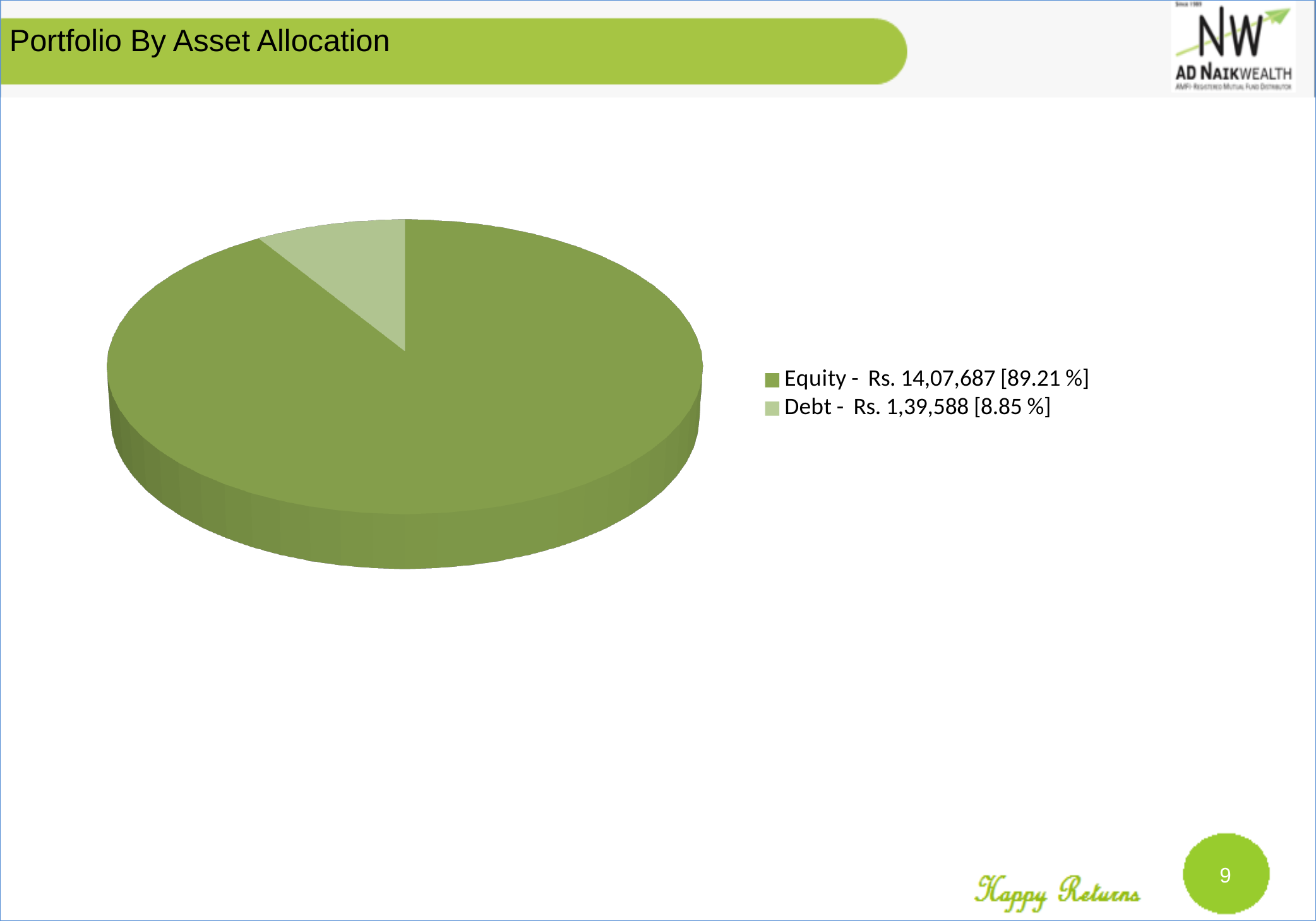
Which category is shown in the lighter green colour in the legend? Debt What is the difference between the Equity value and the Debt value? Rs. 12,68,099 Which category has the largest slice of the pie? Equity What is the value for Debt? Rs. 1,39,588 What kind of chart is shown on the slide? Pie chart Which is larger, the value for Equity or the value for Debt? Equity Which category has the smallest slice of the pie? Debt How many categories are shown in the pie chart? 2 What share of the pie does Debt represent? 8.85 % What is the value for Equity? Rs. 14,07,687 What share of the pie does Equity represent? 89.21 % What is the title of the slide containing the chart? Portfolio By Asset Allocation